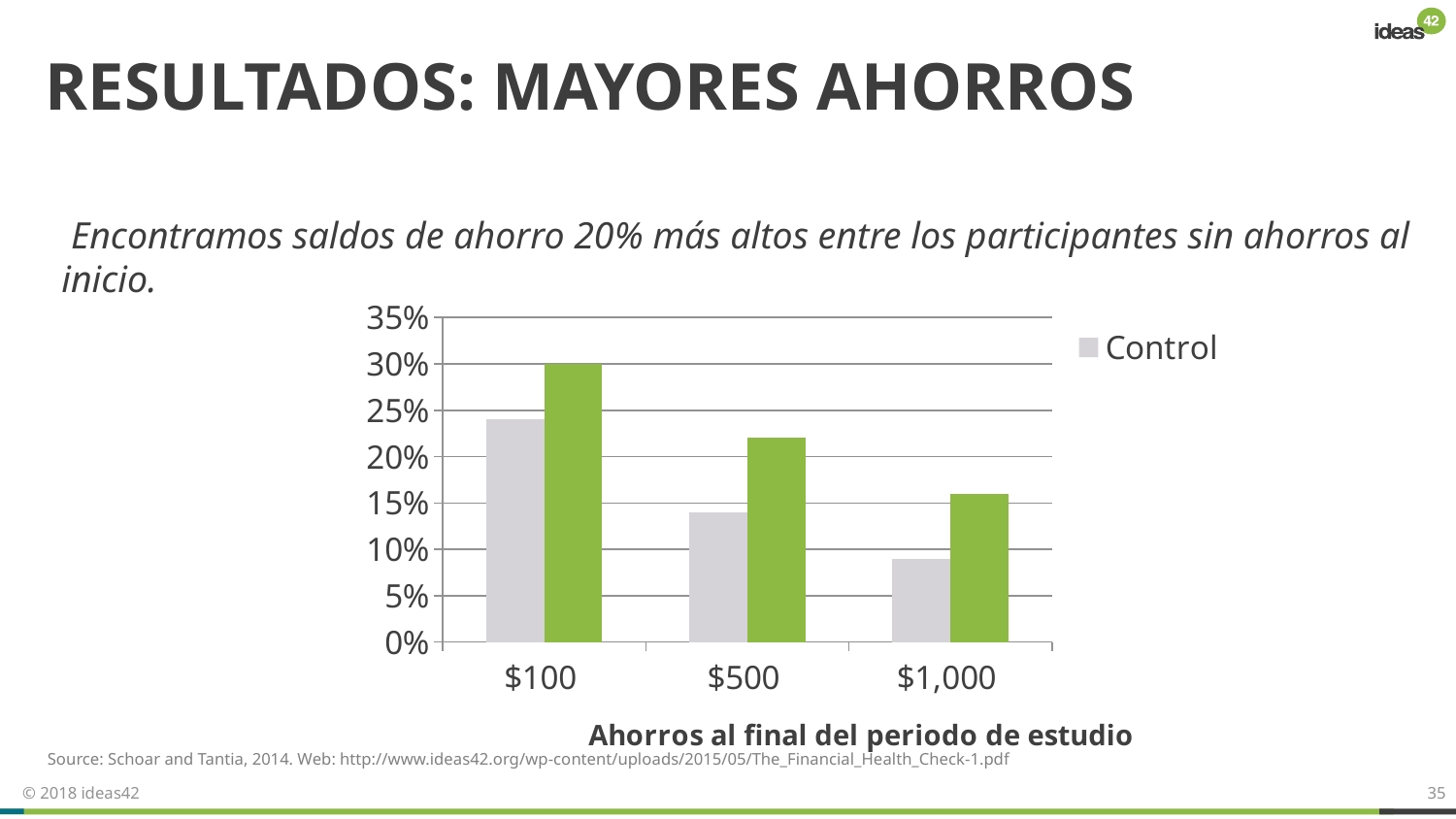
Do the Control values rise or fall as you move from $100 to $1,000 along the x axis? fall What is the title shown below the x axis of the chart? Ahorros al final del periodo de estudio At $100, is the Control bar taller or shorter than the green bar? shorter Is the Control value for $1,000 greater or less than 10%? less Is the green bar for $1,000 greater or less than 20%? less What kind of chart is shown on the slide? bar chart Is the green bar for $500 greater or less than 20%? greater Which category has the highest Control value? $100 Which category has the lowest Control value? $1,000 How many categories are shown on the x axis of the chart? 3